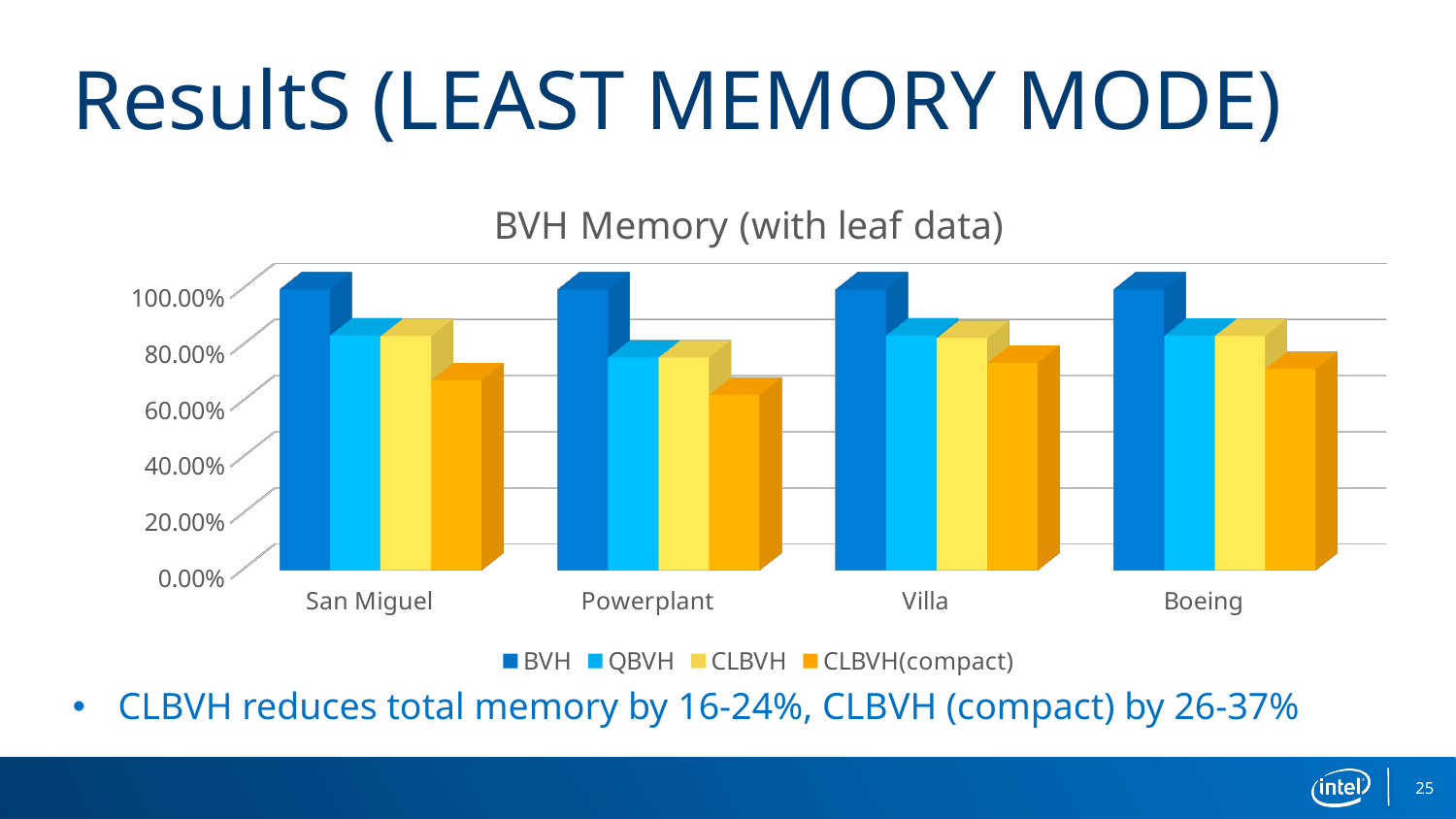
Which series has the lowest value for Powerplant? CLBVH(compact) Which series is shown in orange in the chart legend? CLBVH(compact) Which series has the highest value for Villa? BVH What is the value of the BVH series for Boeing? 100.00% How many series does the legend of the BVH Memory chart list? 4 Is the value of QBVH for Villa greater or less than 60.00%? greater What is the value of the BVH series for San Miguel? 100.00% What type of chart is shown on the slide? bar chart What is the title of the chart? BVH Memory (with leaf data) Which is larger for San Miguel, the QBVH value or the CLBVH(compact) value? QBVH Is the value of CLBVH(compact) for Powerplant greater or less than 80.00%? less How many scene categories are shown on the x axis of the BVH Memory chart? 4